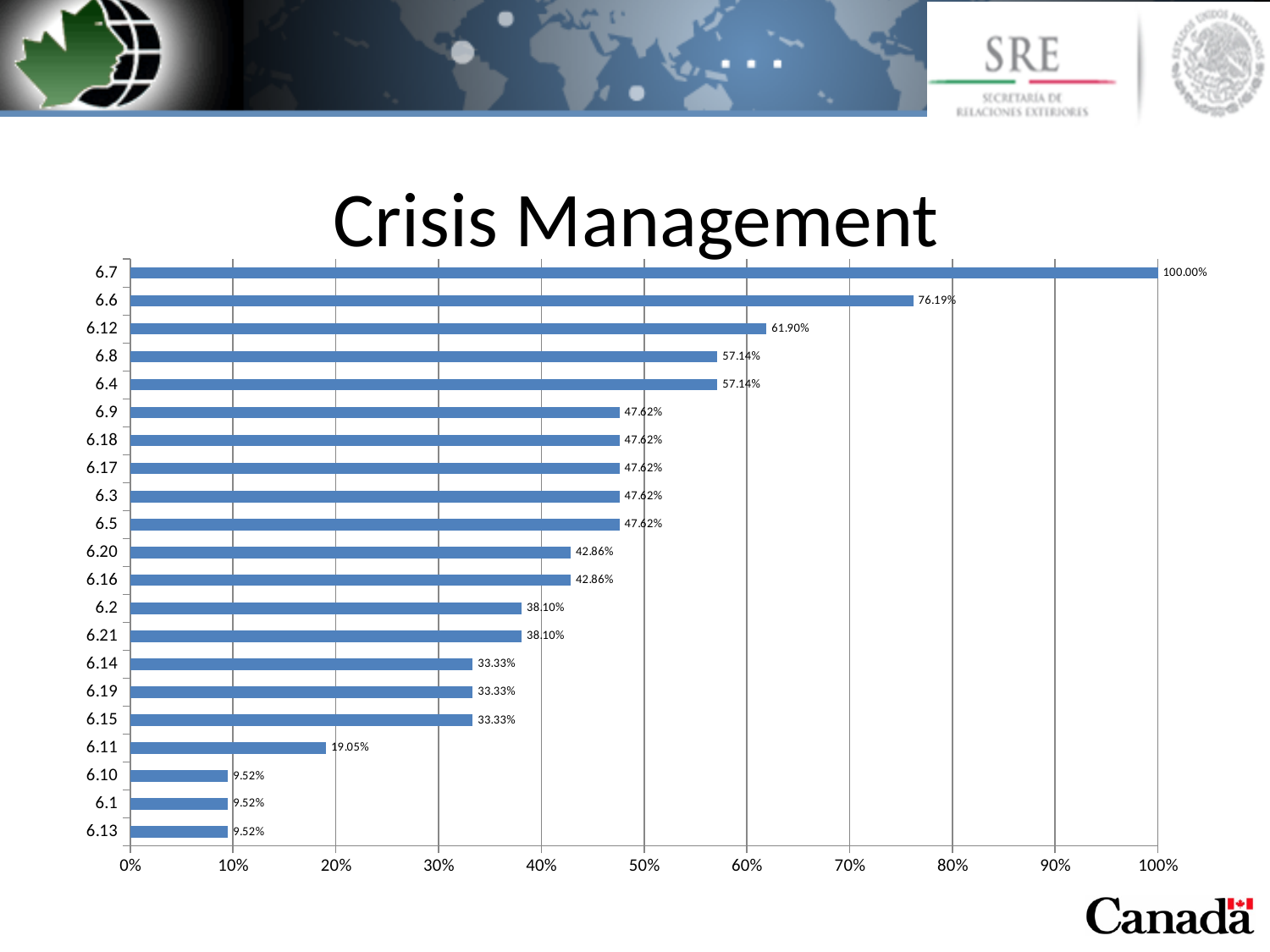
What is the value for 6.20? 42.86% What kind of chart is shown on the slide? bar chart What is the value for 6.12? 61.90% Is the value for 6.6 greater or less than 70%? greater What is the value for 6.11? 19.05% How many categories are shown on the chart? 21 What is the difference between the values for 6.7 and 6.11? 80.95% Which category has the highest value? 6.7 What is the value for 6.7? 100.00% What is the difference between the values for 6.6 and 6.12? 14.29% What is the title of the chart? Crisis Management Which is larger, the value for 6.8 or the value for 6.9? 6.8